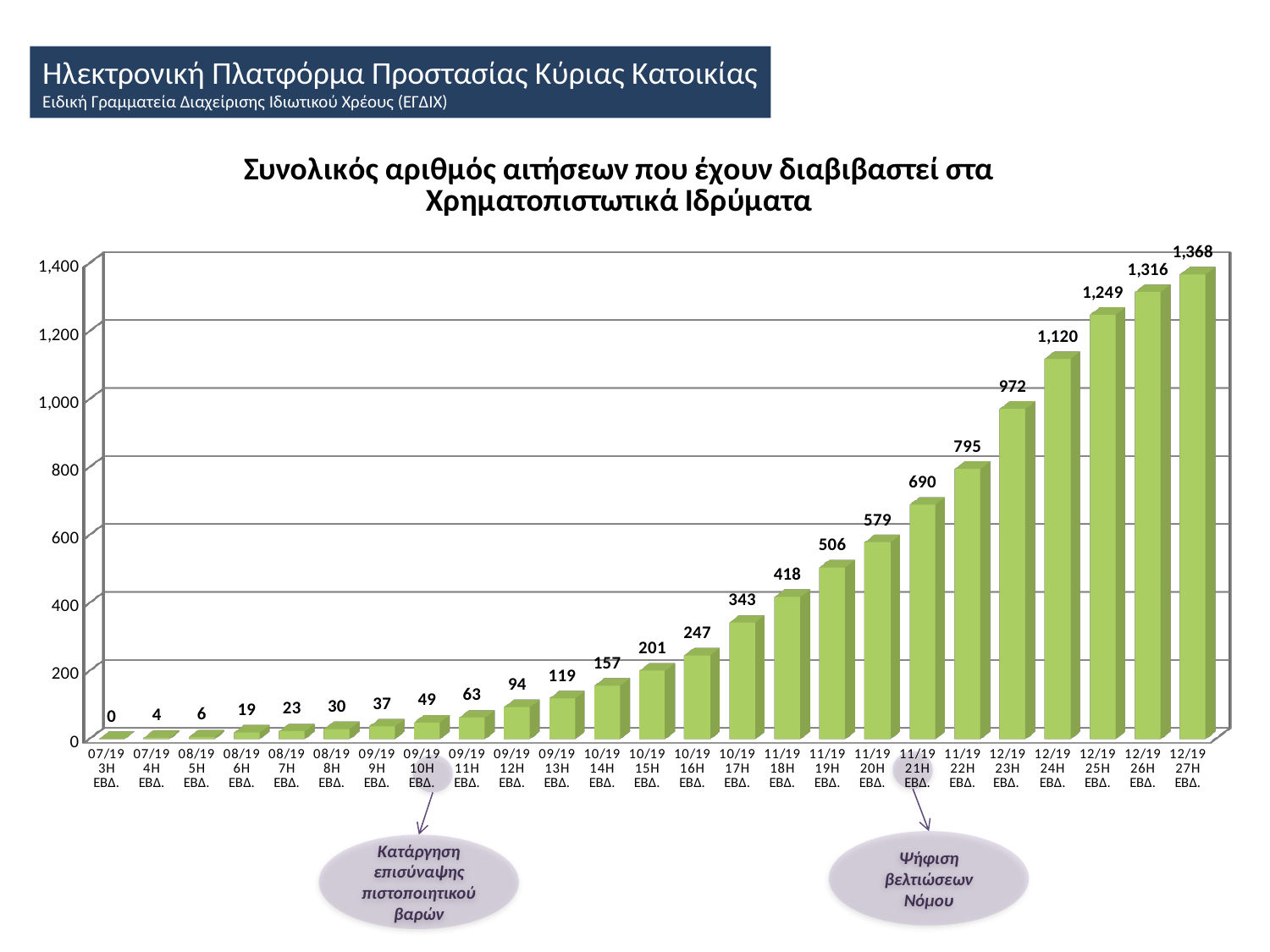
What is the difference between the values for 12/19 24Η ΕΒΔ. and 12/19 23Η ΕΒΔ.? 148 What is the value for 10/19 17Η ΕΒΔ.? 343 Which week has the highest value? 12/19 27Η ΕΒΔ. How many bars are plotted in the chart? 25 Which is larger, the value for 11/19 19Η ΕΒΔ. or the value for 11/19 20Η ΕΒΔ.? 11/19 20Η ΕΒΔ. What is the title of the chart? Συνολικός αριθμός αιτήσεων που έχουν διαβιβαστεί στα Χρηματοπιστωτικά Ιδρύματα What is the value for 12/19 27Η ΕΒΔ.? 1,368 Do the values rise or fall from left to right along the x axis? rise Which week has the lowest value? 07/19 3Η ΕΒΔ. What kind of chart is shown on the slide? bar chart What is the value for 09/19 10Η ΕΒΔ.? 49 What is the value for 11/19 21Η ΕΒΔ.? 690